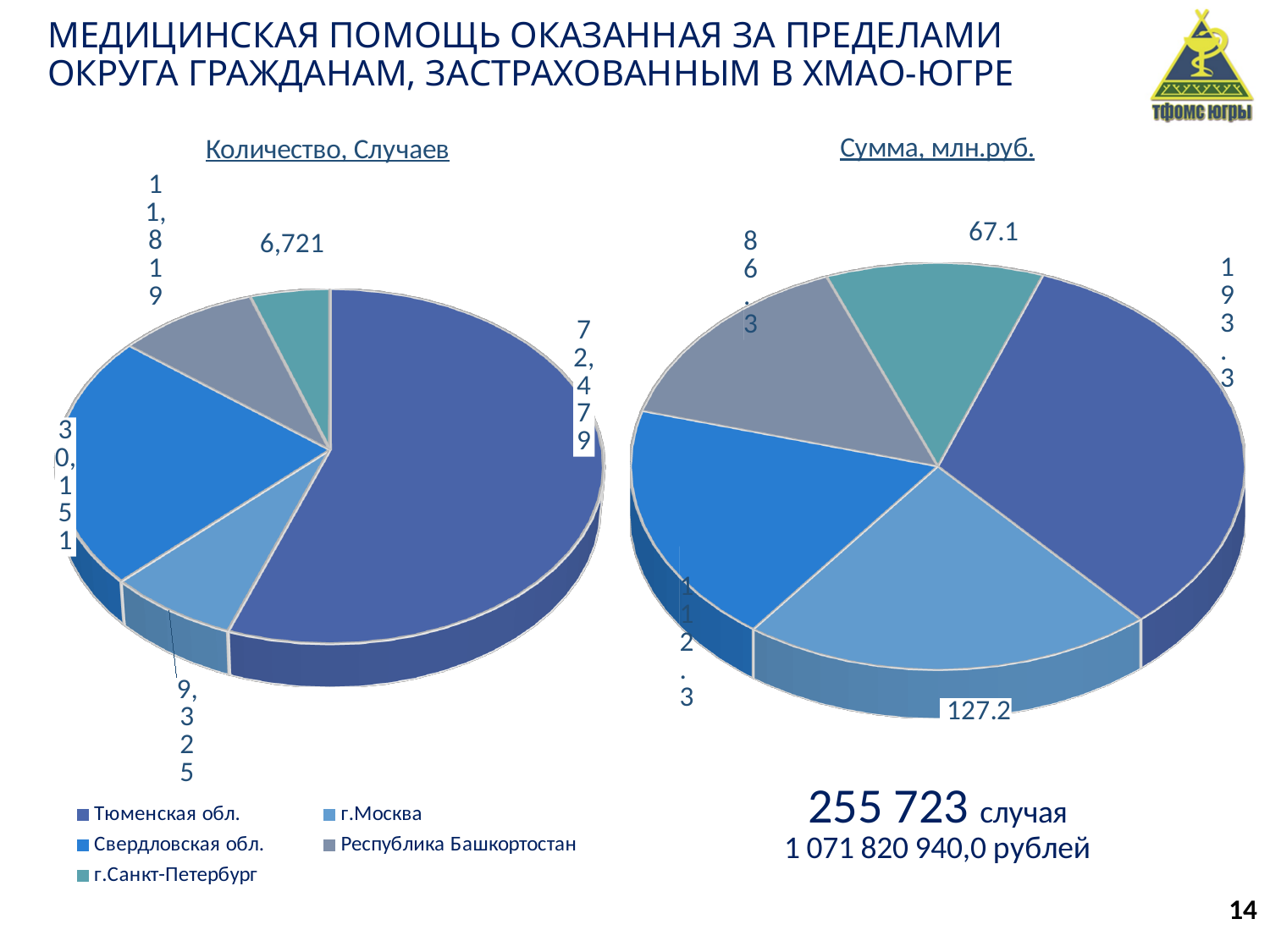
In the chart titled "Сумма, млн.руб.", which category has the largest slice? Тюменская обл. In the chart titled "Сумма, млн.руб.", what is the difference between the values for г.Москва and г.Санкт-Петербург? 60.1 In the chart titled "Количество, Случаев", what is the value for г.Санкт-Петербург? 6,721 In the chart titled "Количество, Случаев", which is larger: the value for Свердловская обл. or the value for Республика Башкортостан? Свердловская обл. In the chart titled "Количество, Случаев", which category has the smallest slice? г.Санкт-Петербург In the chart titled "Количество, Случаев", what is the value for Свердловская обл.? 30,151 In the chart titled "Сумма, млн.руб.", what is the value for г.Москва? 127.2 In the chart titled "Количество, Случаев", what is the value for Тюменская обл.? 72,479 What type of chart is the chart titled "Сумма, млн.руб."? Pie chart In the chart titled "Количество, Случаев", what colour is the slice for г.Санкт-Петербург? Teal How many categories does the legend list for the pie charts? 5 In the chart titled "Сумма, млн.руб.", what is the value for г.Санкт-Петербург? 67.1